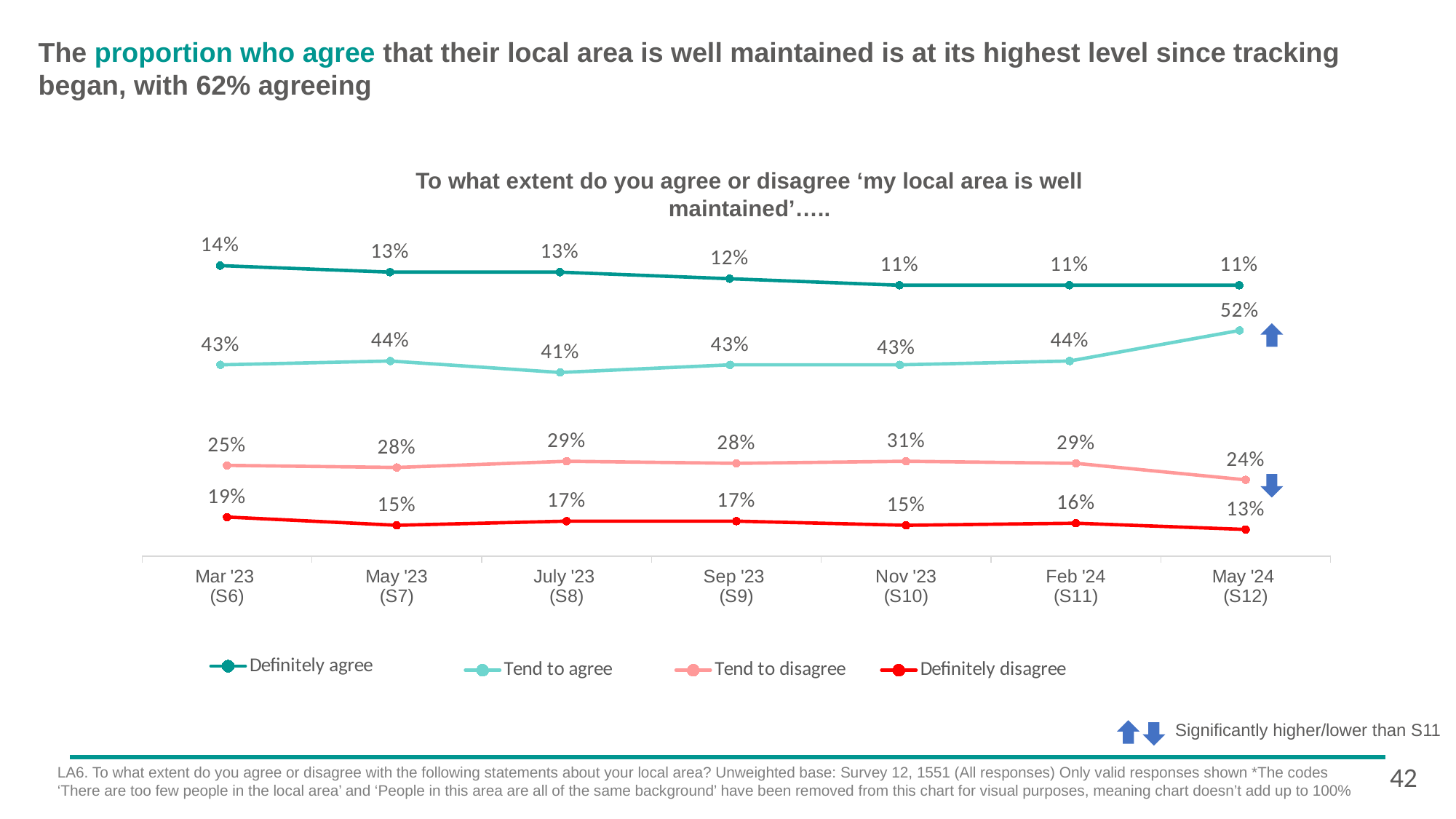
Which is larger in Mar '23 (S6): Tend to disagree or Definitely disagree? Tend to disagree What is the difference between Tend to agree in May '24 (S12) and Feb '24 (S11)? 8 percentage points How many series does the legend list? 4 Does the Definitely agree series rise or fall from Mar '23 (S6) to May '24 (S12)? Fall What is the value for Tend to disagree in Nov '23 (S10)? 31% In which survey wave is Tend to agree at its highest? May '24 (S12) What kind of chart is shown on the slide? Line chart In which survey wave is Tend to agree at its lowest? July '23 (S8) What is the value for Definitely agree in Mar '23 (S6)? 14% What is the value for Tend to agree in May '24 (S12)? 52% How many survey waves are shown on the x axis? 7 What is the value for Definitely disagree in May '24 (S12)? 13%